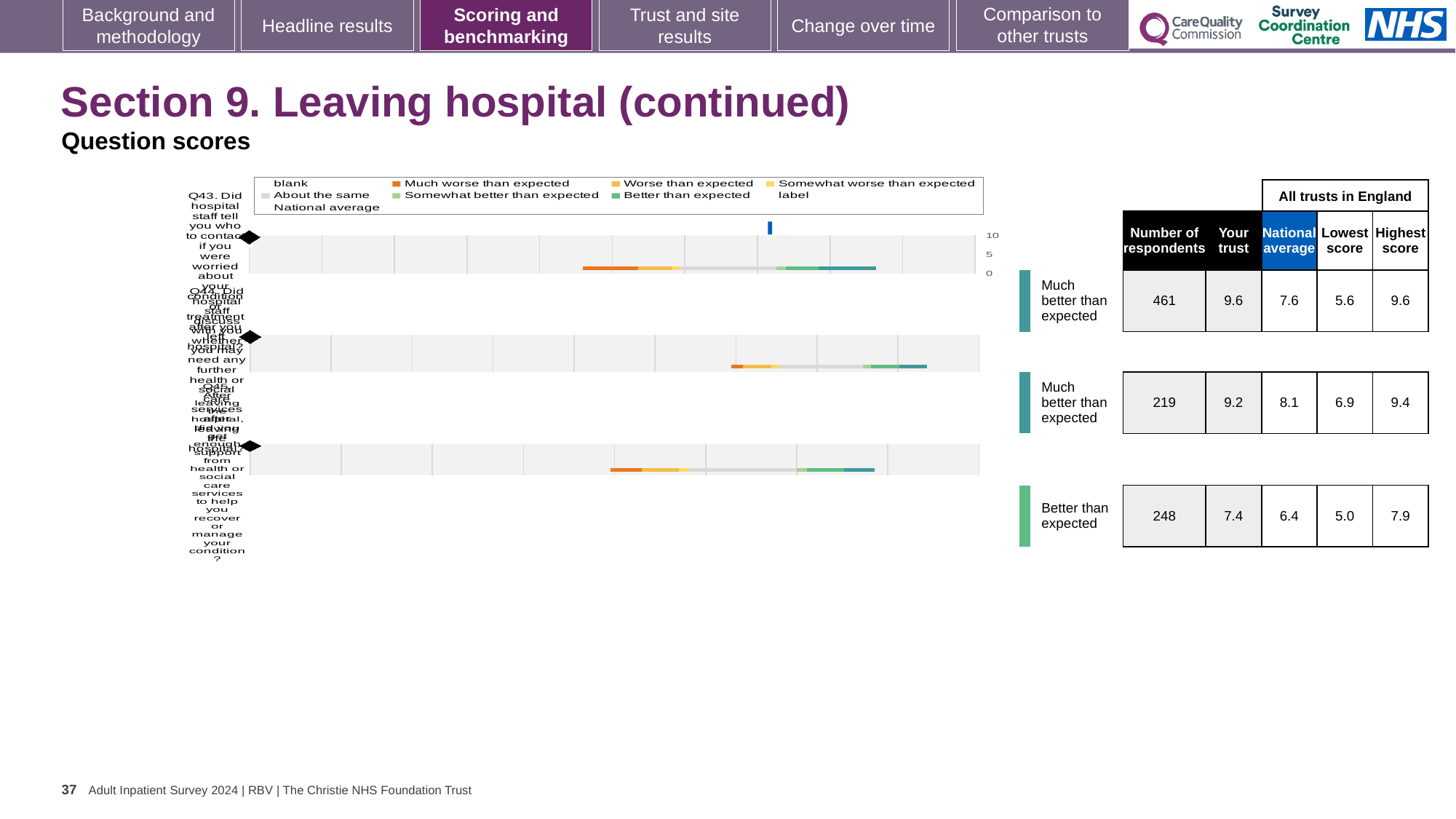
For Q45, which is larger: the 'Your trust' score or the national average? Your trust In the table beside the chart, what is the number of respondents for Q43? 461 Which question has the lowest 'Your trust' score in the table beside the chart? Q45 How many questions (rows) are plotted in the question scores chart? 3 In the table beside the chart, what is the lowest score across all trusts in England for Q45? 5.0 What is the highest value shown on the chart's score axis? 10 What is the difference between the 'Your trust' score and the national average for Q43? 2.0 Which question has the largest number of respondents in the table beside the chart? Q43 In the table beside the chart, what is the 'Your trust' score for Q43? 9.6 What kind of chart is used to show the question scores on this slide? bar chart In the table beside the chart, what is the highest score across all trusts in England for Q44? 9.4 In the table beside the chart, what is the national average score for Q44? 8.1